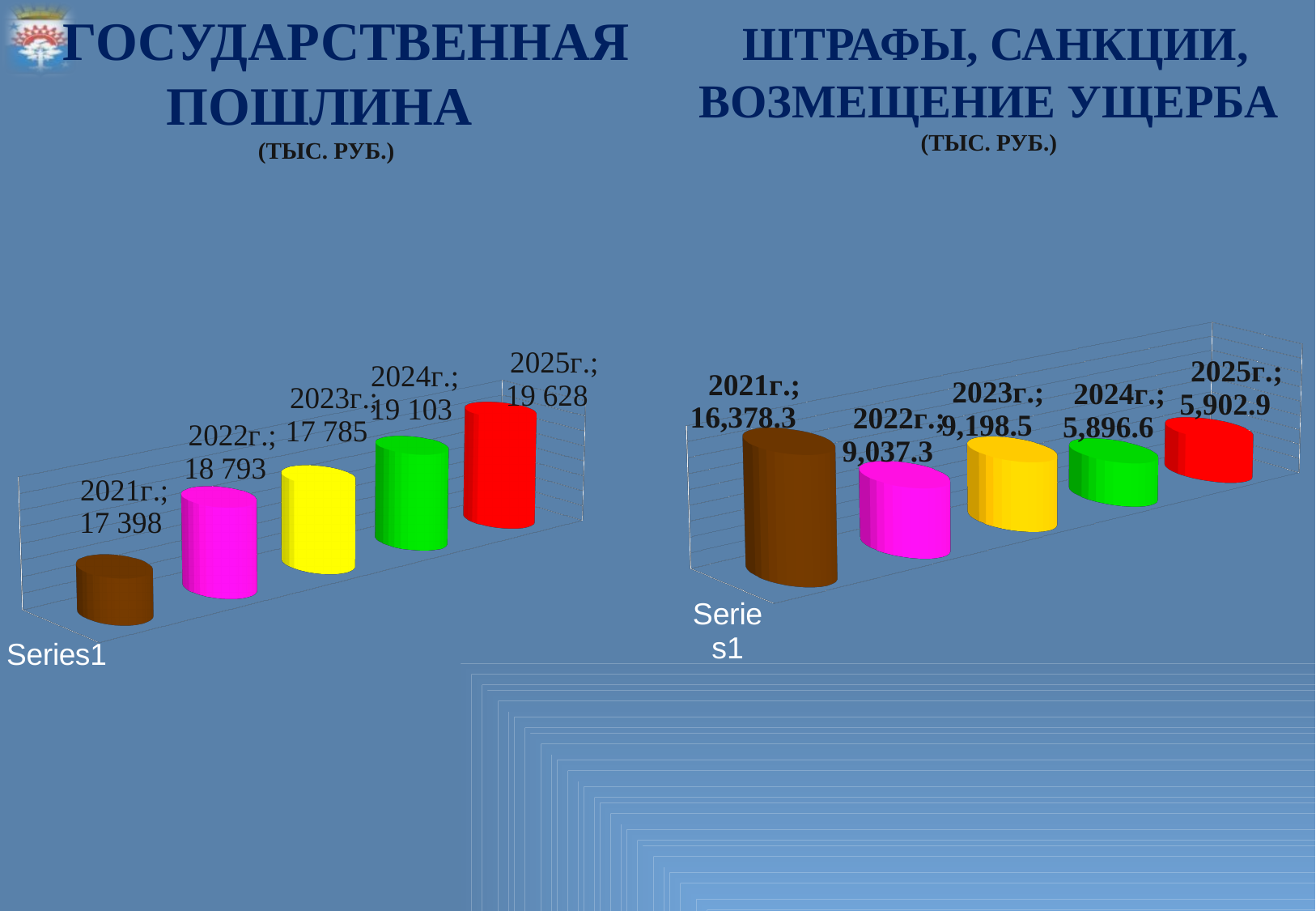
In the chart titled ГОСУДАРСТВЕННАЯ ПОШЛИНА, what is the value for 2021г.? 17 398 In the chart titled ШТРАФЫ, САНКЦИИ, ВОЗМЕЩЕНИЕ УЩЕРБА, what is the value for 2023г.? 9,198.5 In the chart titled ГОСУДАРСТВЕННАЯ ПОШЛИНА, which year has the highest value? 2025г. In the chart titled ГОСУДАРСТВЕННАЯ ПОШЛИНА, which is larger, the value for 2022г. or 2023г.? 2022г. In the chart titled ГОСУДАРСТВЕННАЯ ПОШЛИНА, what is the difference between the values for 2025г. and 2021г.? 2 230 In the chart titled ГОСУДАРСТВЕННАЯ ПОШЛИНА, what is the value for 2024г.? 19 103 In the chart titled ГОСУДАРСТВЕННАЯ ПОШЛИНА, which year has the lowest value? 2021г. In the chart titled ШТРАФЫ, САНКЦИИ, ВОЗМЕЩЕНИЕ УЩЕРБА, what is the difference between the values for 2021г. and 2022г.? 7,341.0 In the chart titled ШТРАФЫ, САНКЦИИ, ВОЗМЕЩЕНИЕ УЩЕРБА, which year has the highest value? 2021г. How many years are plotted in the chart titled ШТРАФЫ, САНКЦИИ, ВОЗМЕЩЕНИЕ УЩЕРБА? 5 What kind of chart is the chart titled ГОСУДАРСТВЕННАЯ ПОШЛИНА? Bar chart In the chart titled ШТРАФЫ, САНКЦИИ, ВОЗМЕЩЕНИЕ УЩЕРБА, what is the value for 2021г.? 16,378.3